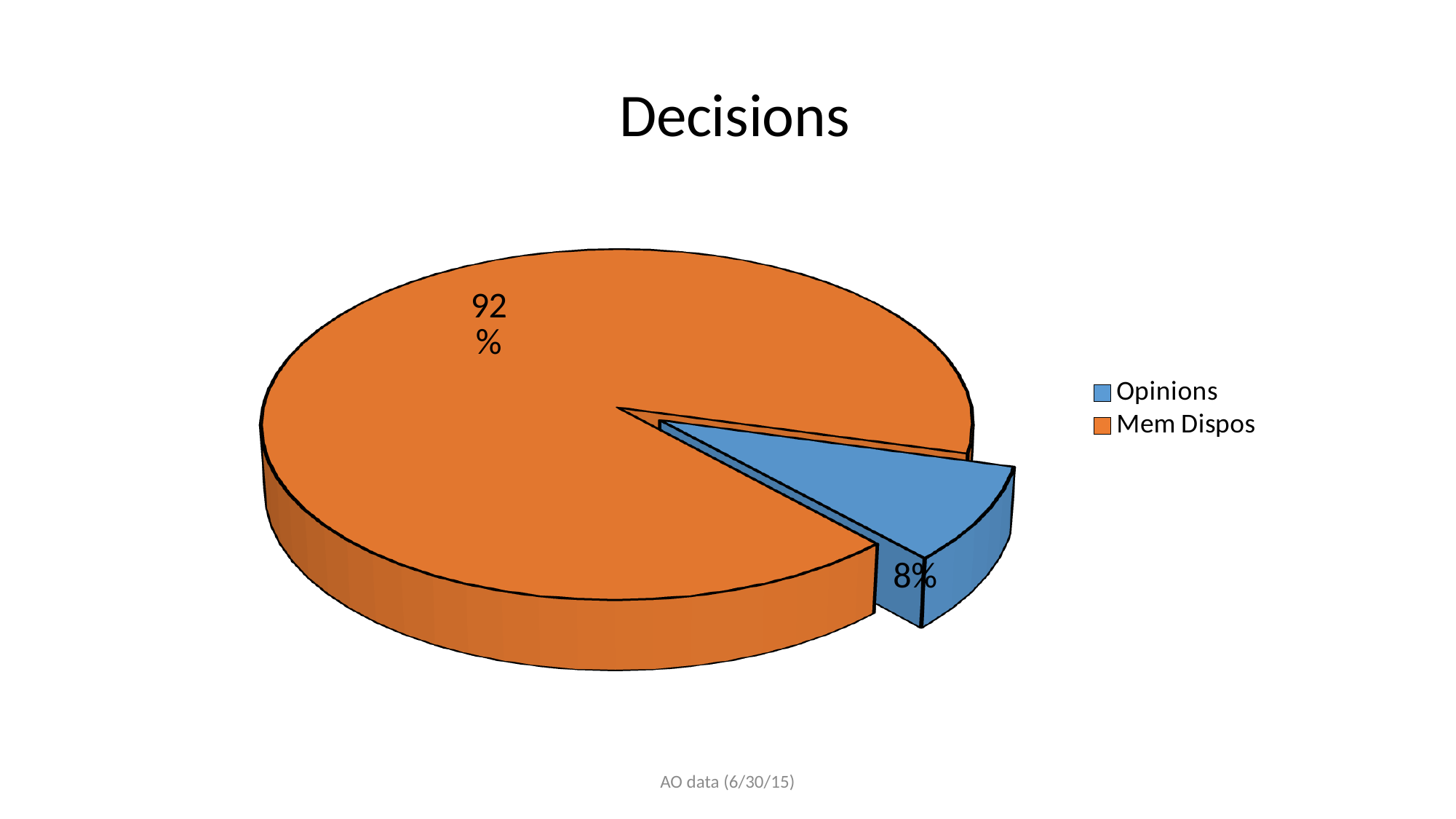
What share of the pie is Opinions? 8% What is the title of the chart? Decisions What is the difference in percentage points between the Mem Dispos and Opinions slices? 84 How many entries does the legend list? 2 What share of the pie is Mem Dispos? 92% What kind of chart is shown on the slide? pie chart Which category has the largest slice of the pie? Mem Dispos How many slices does the pie chart have? 2 What colour is the Opinions slice? blue Which category has the smallest slice of the pie? Opinions Which is larger, the Opinions slice or the Mem Dispos slice? Mem Dispos